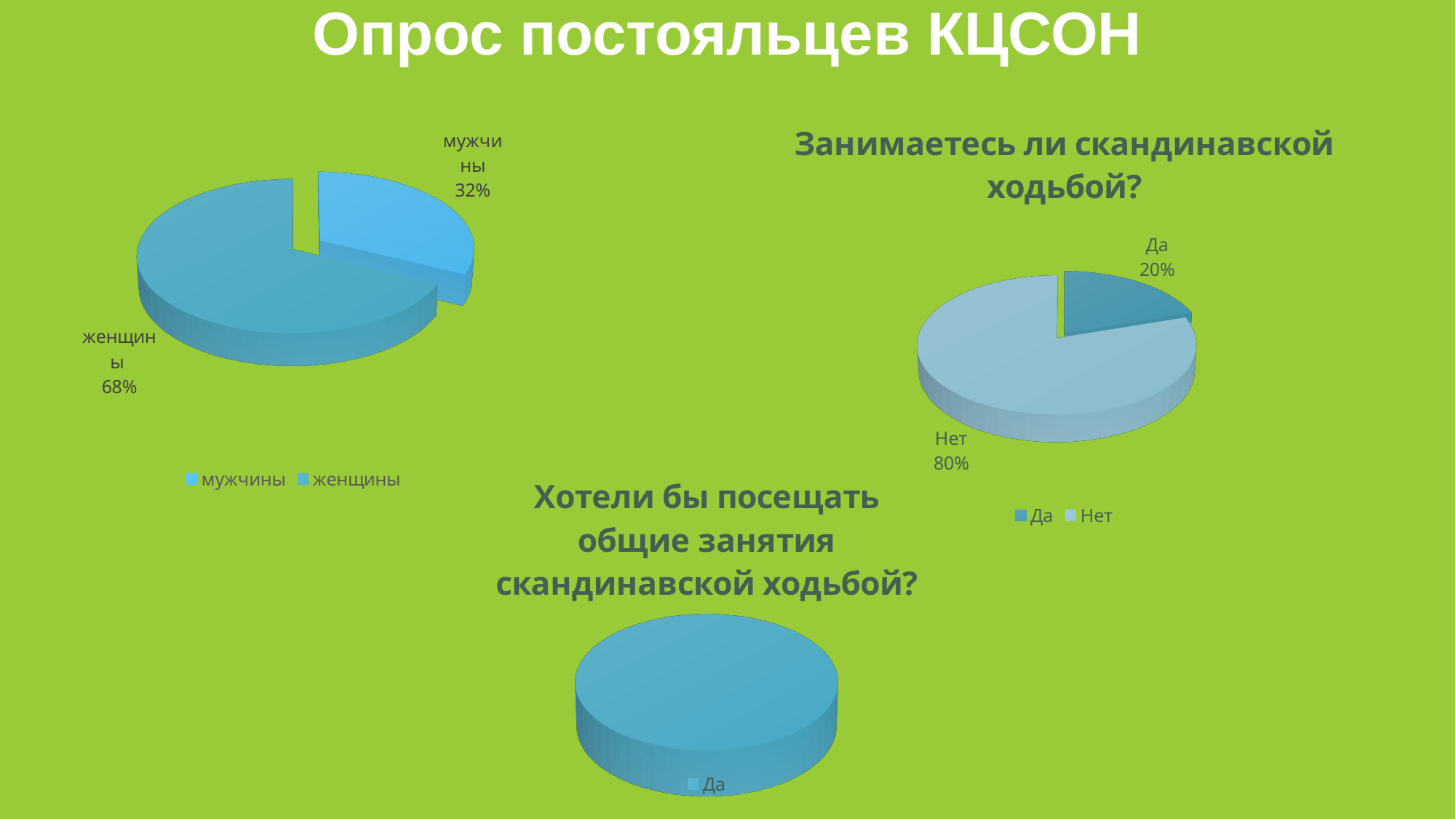
In the chart titled 'Занимаетесь ли скандинавской ходьбой?', what share answered Нет? 80% How many categories does the legend of the pie chart on the left of the slide list? 2 In the chart titled 'Занимаетесь ли скандинавской ходьбой?', what share answered Да? 20% How many entries does the legend of the chart titled 'Хотели бы посещать общие занятия скандинавской ходьбой?' list? 1 What kind of chart is used for 'Хотели бы посещать общие занятия скандинавской ходьбой?'? pie chart In the chart titled 'Занимаетесь ли скандинавской ходьбой?', what is the difference in percentage points between Нет and Да? 60 In the pie chart on the left of the slide, what share is labelled for женщины? 68% In the pie chart on the left of the slide, what share is labelled for мужчины? 32% In the pie chart on the left of the slide, by how many percentage points does женщины exceed мужчины? 36 What is the title of the slide? Опрос постояльцев КЦСОН In the pie chart on the left of the slide, which category has the larger share? женщины In the chart titled 'Занимаетесь ли скандинавской ходьбой?', which answer has the smallest share? Да